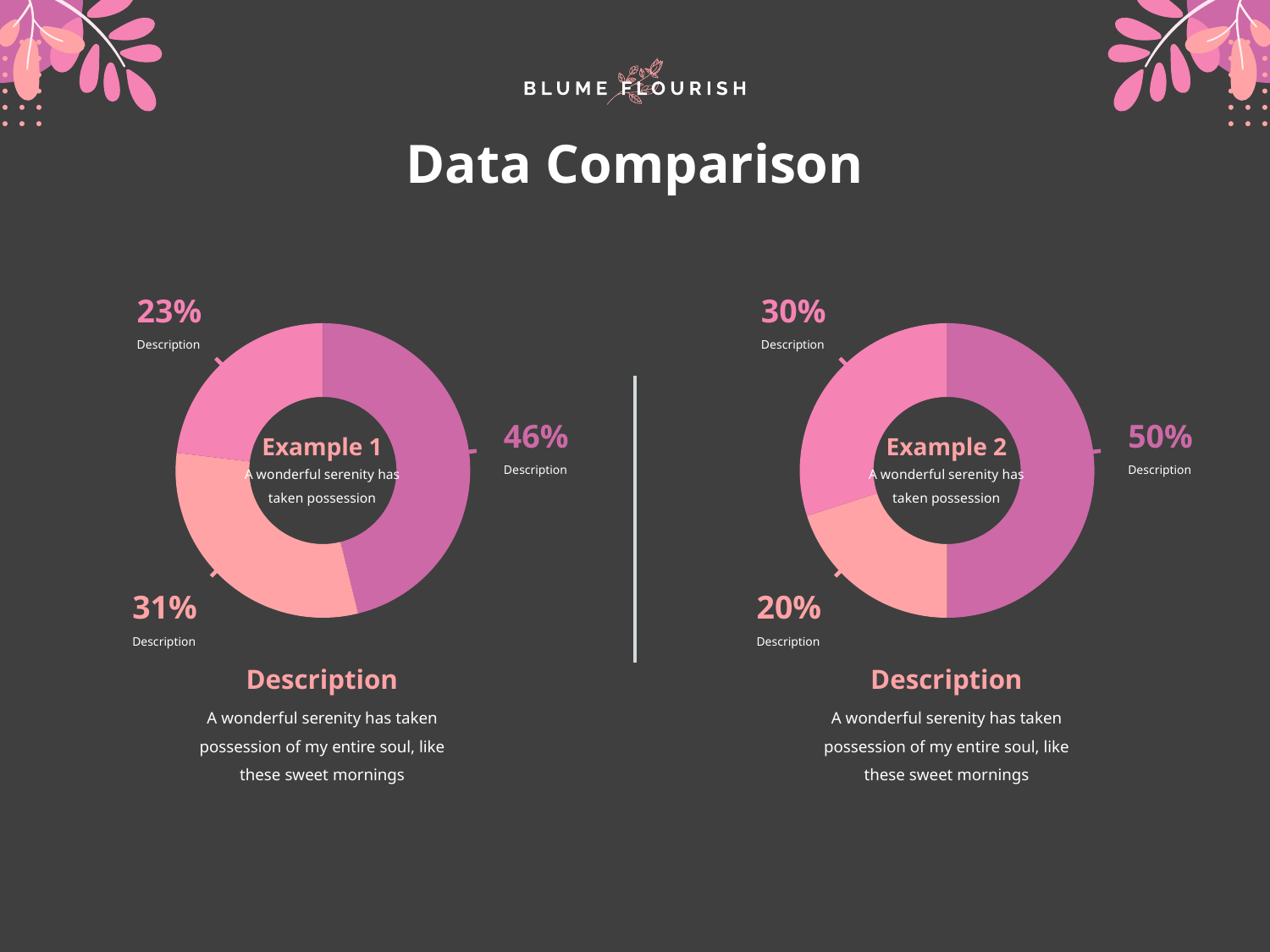
In the Example 1 chart, what is the smallest percentage shown? 23% In the Example 1 chart, what percentage is labelled at the lower left of the donut? 31% Which is larger: the largest slice in Example 1 or the largest slice in Example 2? Example 2 (50%) What is the title of the slide containing the two donut charts? Data Comparison How many slices does the Example 2 donut chart have? 3 In the Example 2 chart, what is the difference between the 50% slice and the 20% slice? 30% What kind of chart is the Example 1 chart? donut chart In the Example 1 chart, what is the largest percentage shown? 46% In the Example 2 chart, what is the largest percentage shown? 50% How many slices does the Example 1 donut chart have? 3 In the Example 2 chart, what is the smallest percentage shown? 20% In the Example 1 chart, what is the difference between the largest slice (46%) and the smallest slice (23%)? 23%